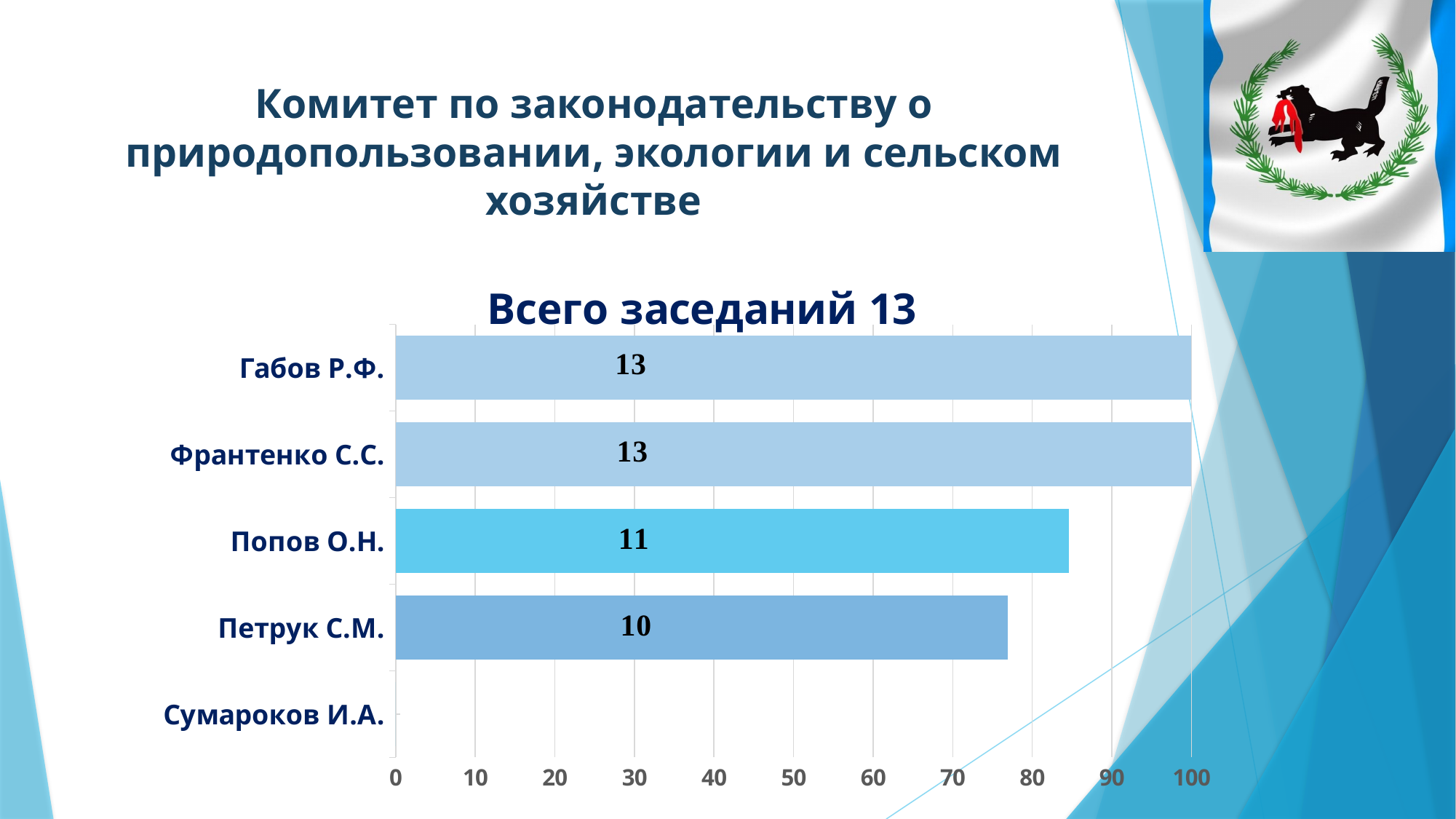
What is the data label on the bar for Попов О.Н.? 11 What is the difference between the labelled values for Попов О.Н. and Петрук С.М.? 1 What is the data label on the bar for Петрук С.М.? 10 What is the data label on the bar for Габов Р.Ф.? 13 Which has the larger labelled value, Попов О.Н. or Петрук С.М.? Попов О.Н. On the horizontal axis, does the bar for Петрук С.М. extend greater or less than 80? less What kind of chart is shown on the slide? bar chart What is the data label on the bar for Франтенко С.С.? 13 What is the title of the chart? Всего заседаний 13 What is the difference between the labelled values for Габов Р.Ф. and Петрук С.М.? 3 How many categories (names) are listed on the vertical axis of the chart? 5 On the horizontal axis, does the bar for Попов О.Н. extend greater or less than 80? greater